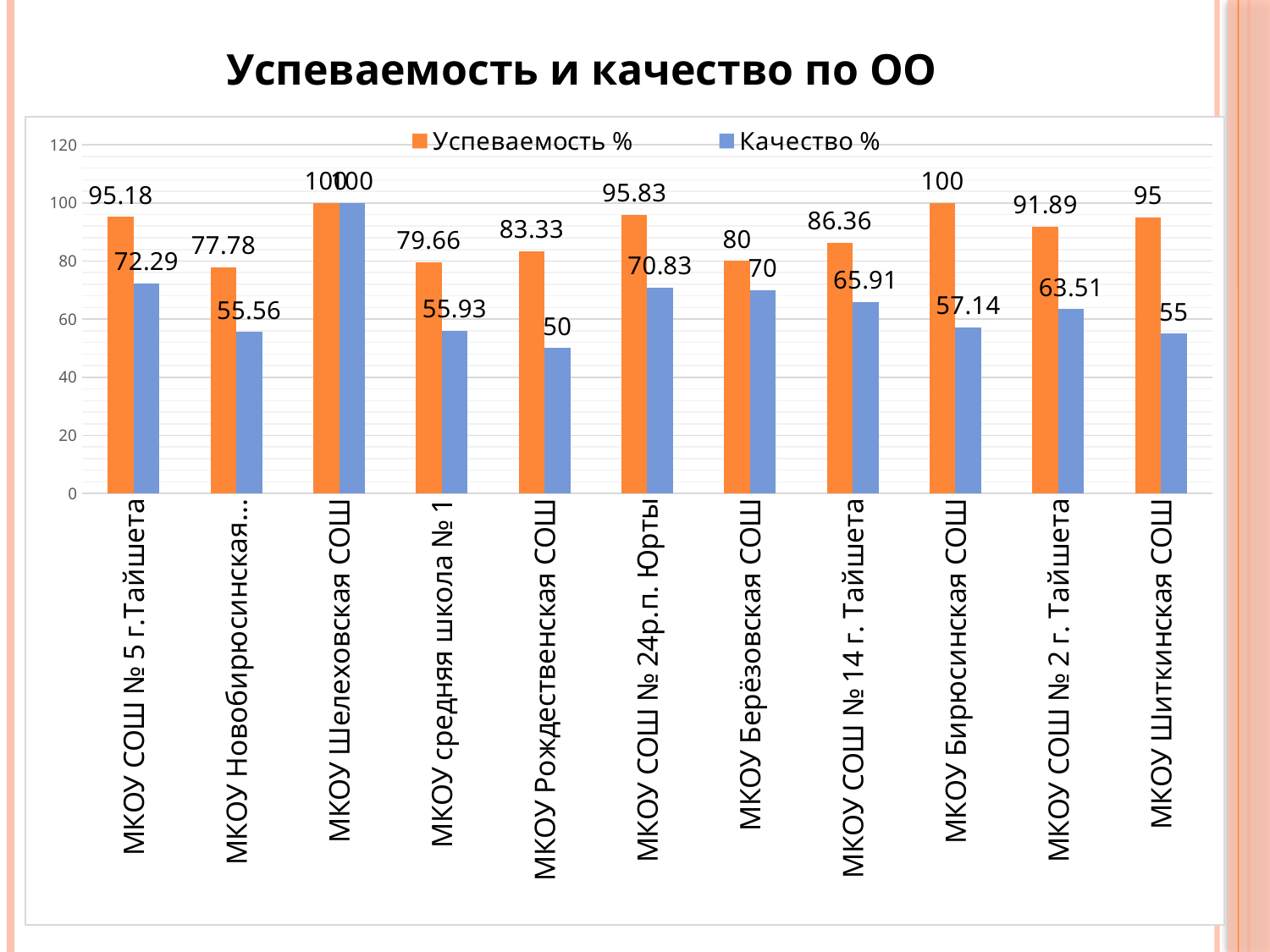
Which is larger: the Качество % value for МКОУ Берёзовская СОШ or for МКОУ СОШ № 14 г. Тайшета? МКОУ Берёзовская СОШ What is the Успеваемость % value for МКОУ СОШ № 5 г.Тайшета? 95.18 What is the Качество % value for МКОУ Бирюсинская СОШ? 57.14 What is the difference between the Успеваемость % and Качество % values for МКОУ СОШ № 5 г.Тайшета? 22.89 What is the Качество % value for МКОУ Рождественская СОШ? 50 How many series does the legend list? 2 What is the Успеваемость % value for МКОУ СОШ № 2 г. Тайшета? 91.89 Is the Успеваемость % value for МКОУ Новобирюсинская... greater or less than 80? less Which school has the lowest Качество % value? МКОУ Рождественская СОШ What type of chart is shown on the slide? bar chart Which school has the highest Качество % value? МКОУ Шелеховская СОШ How many schools are shown on the x axis of the chart? 11